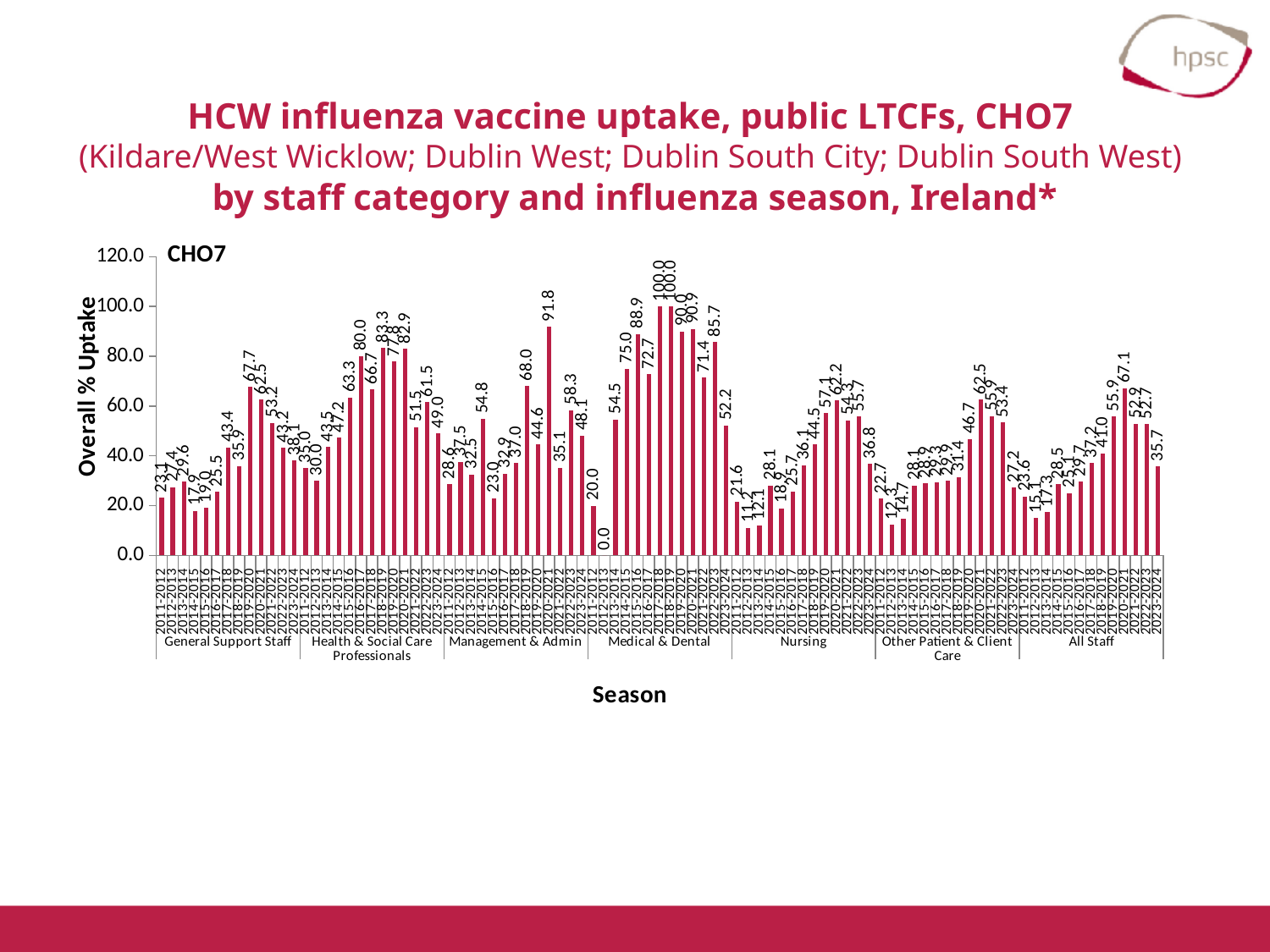
What is the highest overall % uptake value shown in the Management & Admin group? 91.8 What is the label on the vertical axis? Overall % Uptake How many staff category groups are shown along the x axis? 7 What is the overall % uptake for Medical & Dental staff in the 2017-2018 season? 100.0 Is the Medical & Dental uptake for 2015-2016 greater or less than 80.0? greater Which season has the lowest overall % uptake in the Medical & Dental group? 2012-2013 In which season does the All Staff group reach its highest overall % uptake? 2020-2021 For the 2023-2024 season, which group has the higher uptake: Health & Social Care Professionals or General Support Staff? Health & Social Care Professionals What is the difference between the Medical & Dental uptake in 2022-2023 (85.7) and in 2023-2024 (52.2)? 33.5 What is the overall % uptake for Medical & Dental staff in the 2011-2012 season? 20.0 What type of chart is shown on the slide? Bar chart What is the overall % uptake for All Staff in the 2023-2024 season? 35.7